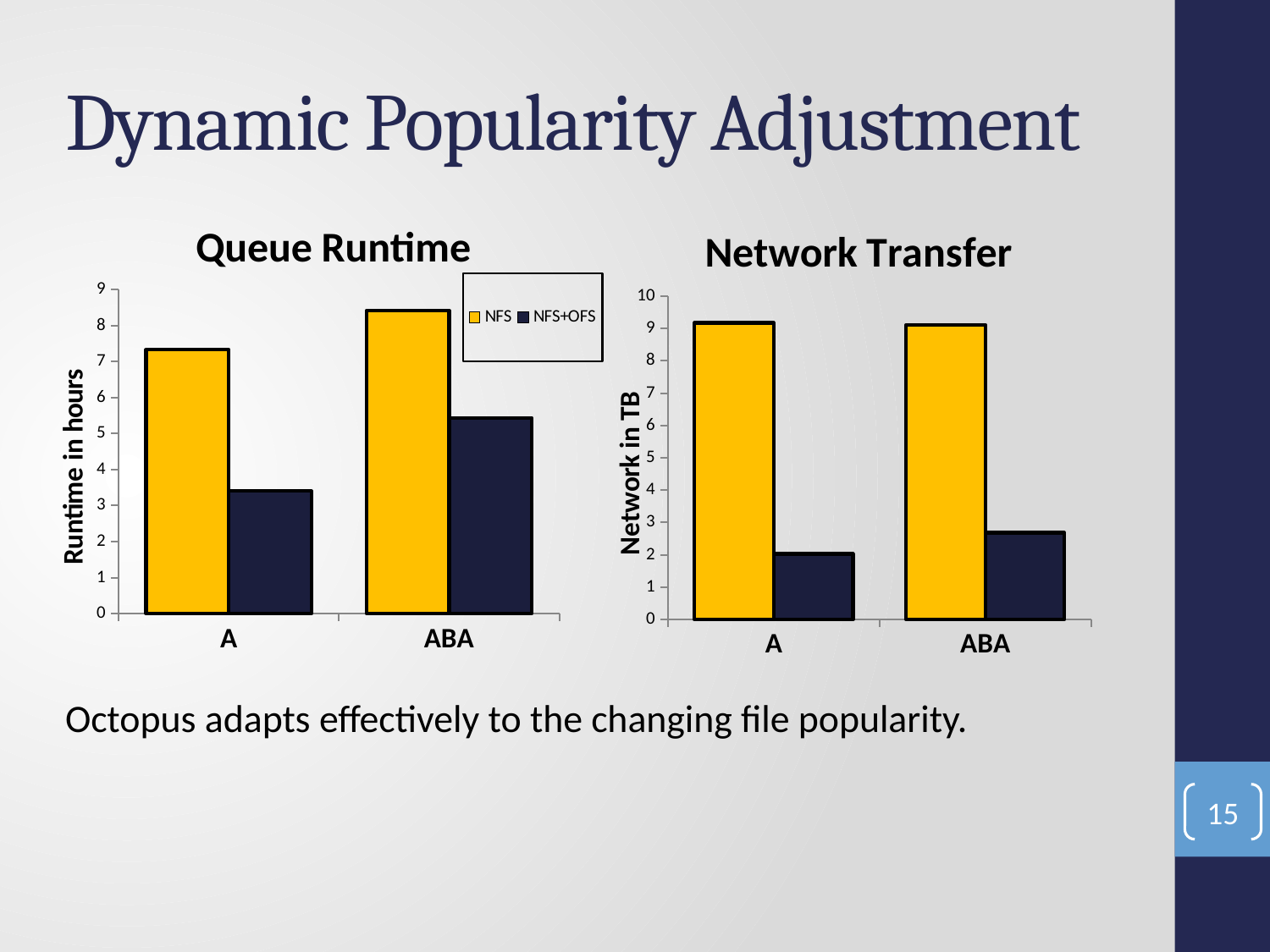
In the Network Transfer chart, is the NFS value for ABA greater or less than 8? greater What kind of chart is the Queue Runtime chart? bar chart In the Queue Runtime chart, is the NFS value for ABA greater or less than 8? greater What is the y-axis label of the Network Transfer chart? Network in TB How many categories are shown on the x axis of the Network Transfer chart? 2 In the Network Transfer chart, which category has the higher NFS+OFS value, A or ABA? ABA In the Queue Runtime chart, which series has the higher value for ABA, NFS or NFS+OFS? NFS In the Queue Runtime chart, is the NFS value for A greater or less than 7? greater In the Queue Runtime chart, which colour represents the NFS series? yellow How many series does the legend of the Queue Runtime chart list? 2